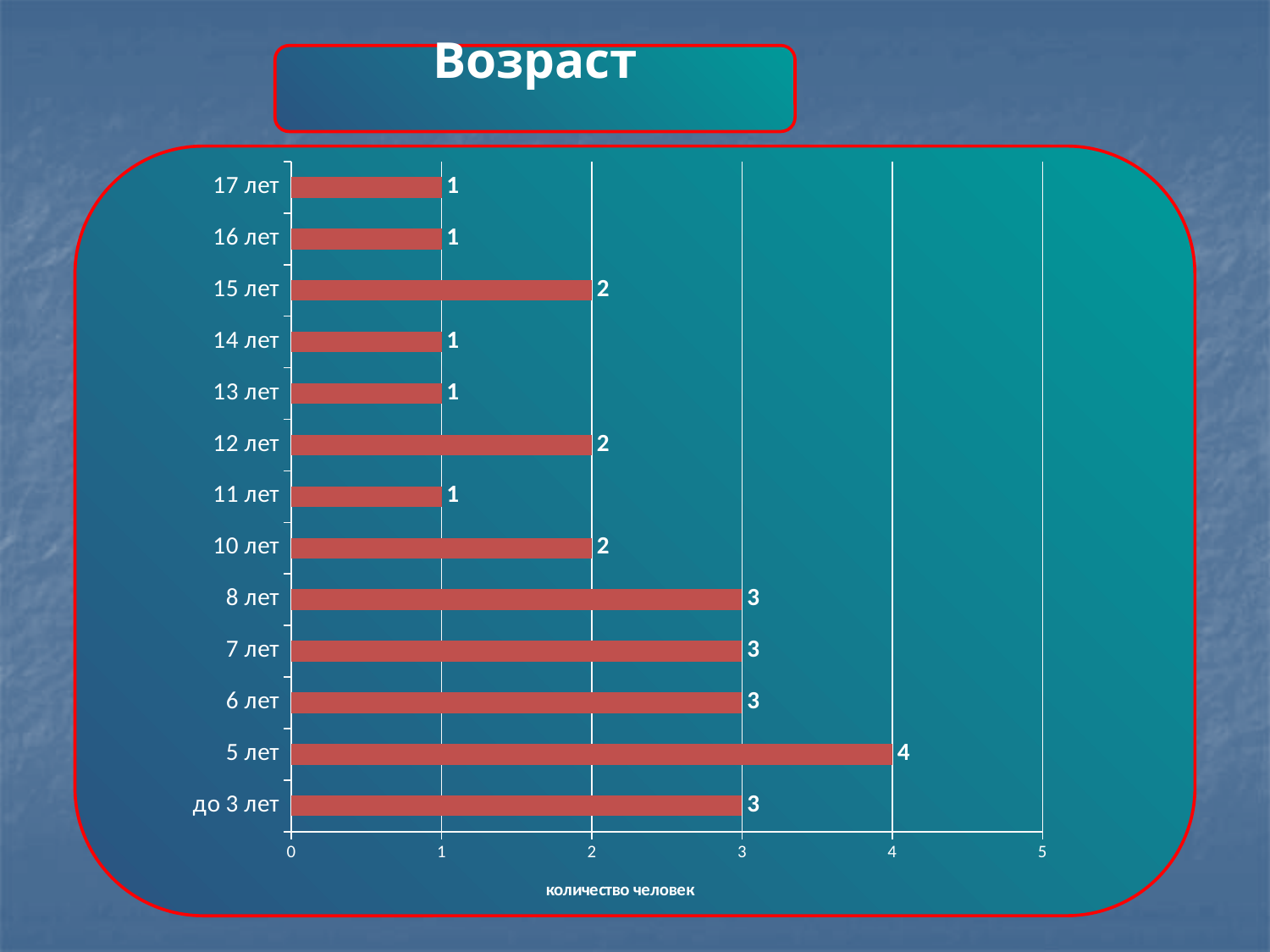
How many categories are shown on the chart? 13 What is the difference between the values for 12 лет and 7 лет? 1 What is the value for до 3 лет? 3 Which category has the highest value? 5 лет What is the difference between the values for 5 лет and 17 лет? 3 What kind of chart is shown on the slide? bar chart Is the value for 6 лет greater or less than 2? greater What is the label of the horizontal axis? количество человек What is the value for 15 лет? 2 What is the title of the chart? Возраст Which is larger, the value for 8 лет or the value for 10 лет? 8 лет What is the value for 5 лет? 4